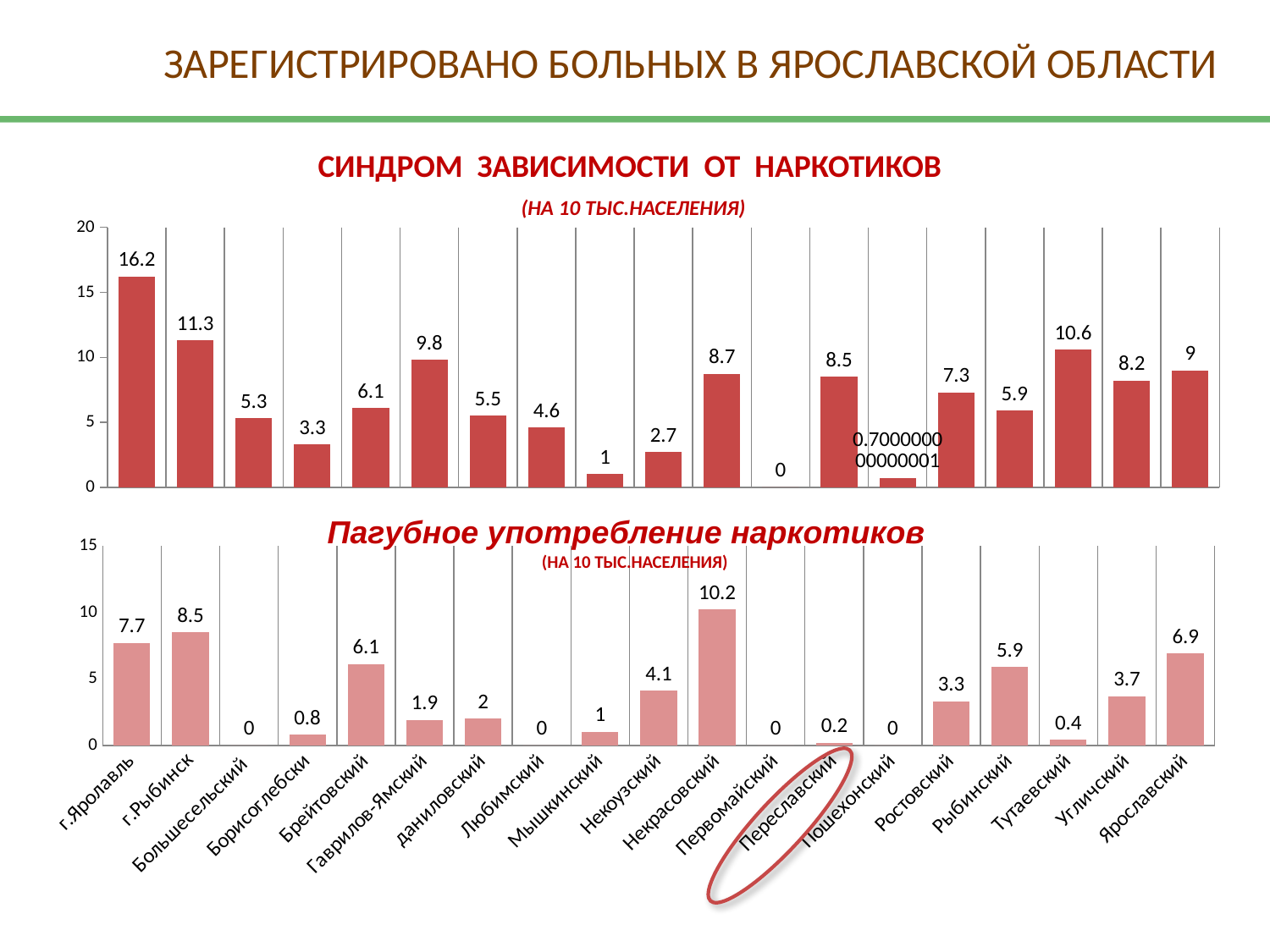
What type of chart is the top chart (Синдром зависимости от наркотиков)? Bar chart In the bottom chart (Пагубное употребление наркотиков), what is the value for Переславский? 0.2 In the bottom chart (Пагубное употребление наркотиков), which category has the highest value? Некрасовский In the top chart (Синдром зависимости от наркотиков), which category has the highest value? г.Ярославль In the top chart (Синдром зависимости от наркотиков), what is the value for Тутаевский? 10.6 In the bottom chart (Пагубное употребление наркотиков), what is the difference between г.Рыбинск and г.Ярославль? 0.8 In the top chart (Синдром зависимости от наркотиков), what is the difference between г.Ярославль and г.Рыбинск? 4.9 In the top chart (Синдром зависимости от наркотиков), which is larger: Гаврилов-Ямский or Некрасовский? Гаврилов-Ямский Which category label on the bottom chart is circled? Переславский In the top chart (Синдром зависимости от наркотиков), what is the value for г.Ярославль? 16.2 In the bottom chart (Пагубное употребление наркотиков), what is the value for Ярославский? 6.9 How many categories are shown on the x axis of the bottom chart (Пагубное употребление наркотиков)? 19